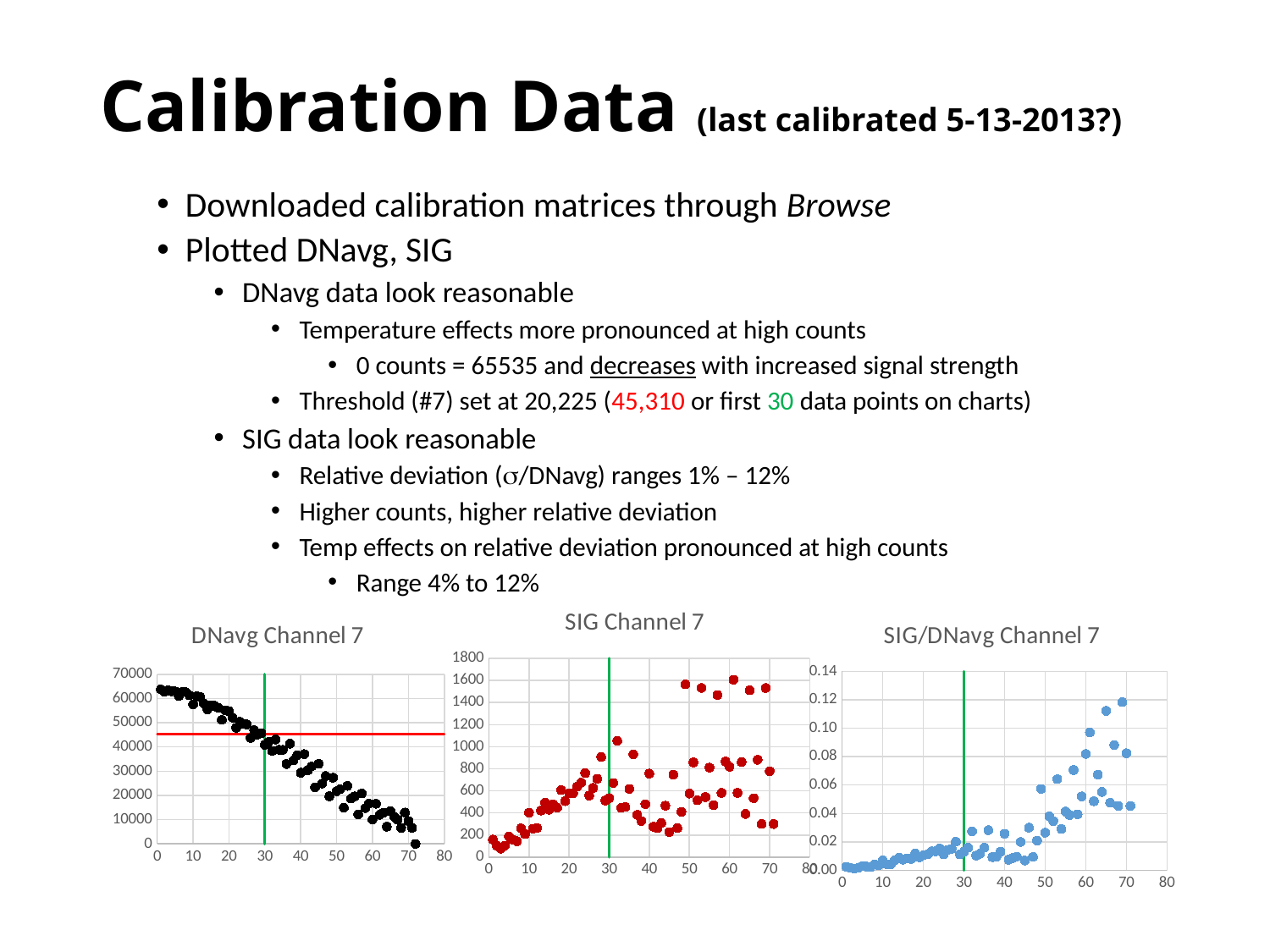
In the SIG/DNavg Channel 7 chart, is the value at x = 10 greater or less than 0.02? less What kind of chart is the DNavg Channel 7 chart? scatter chart In the SIG/DNavg Channel 7 chart, is the highest plotted value greater or less than 0.10? greater In the SIG Channel 7 chart, is the highest plotted value greater or less than 1400? greater In the SIG/DNavg Channel 7 chart, do the values generally rise or fall as the x value increases? rise How many charts are shown on the slide? 3 In the DNavg Channel 7 chart, do the values rise or fall as the x value increases? fall In the DNavg Channel 7 chart, which is larger: the value at x = 0 or the value at x = 70? the value at x = 0 What colour are the data points in the SIG Channel 7 chart? red